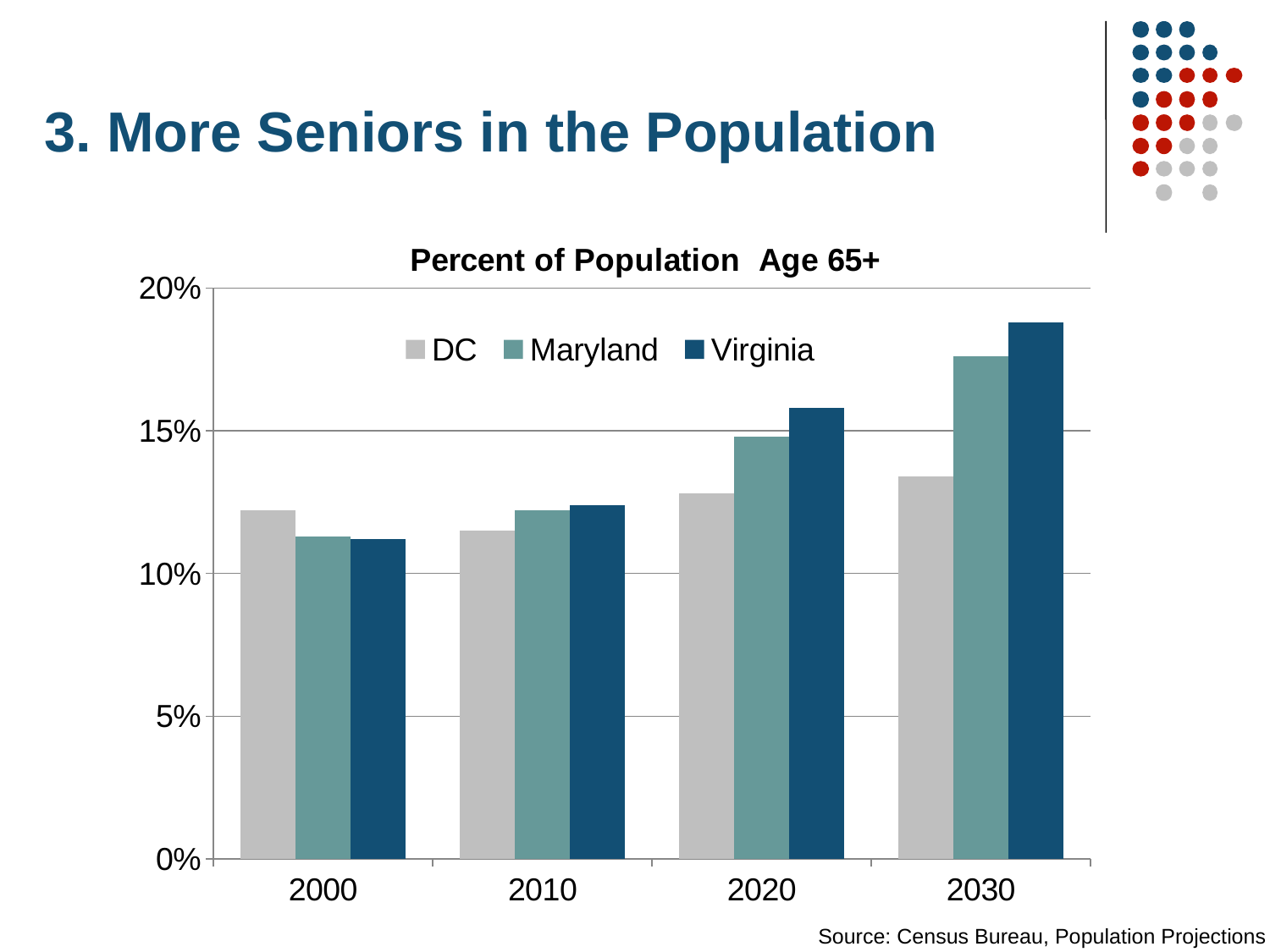
Which series is shown in the darkest blue colour? Virginia How many series does the legend list? 3 Is the value for DC in 2030 greater or less than 15%? less Which series has the highest value in 2030? Virginia What kind of chart is shown on the slide? bar chart Is the value for Virginia in 2030 greater or less than 15%? greater How many years are shown on the x axis? 4 Is the value for Virginia in 2020 greater or less than 15%? greater Which series has the lowest value in 2030? DC What is the title of the chart? Percent of Population Age 65+ In 2000, which is larger, the value for DC or the value for Maryland? DC Do the values for Virginia rise or fall from 2000 to 2030? rise